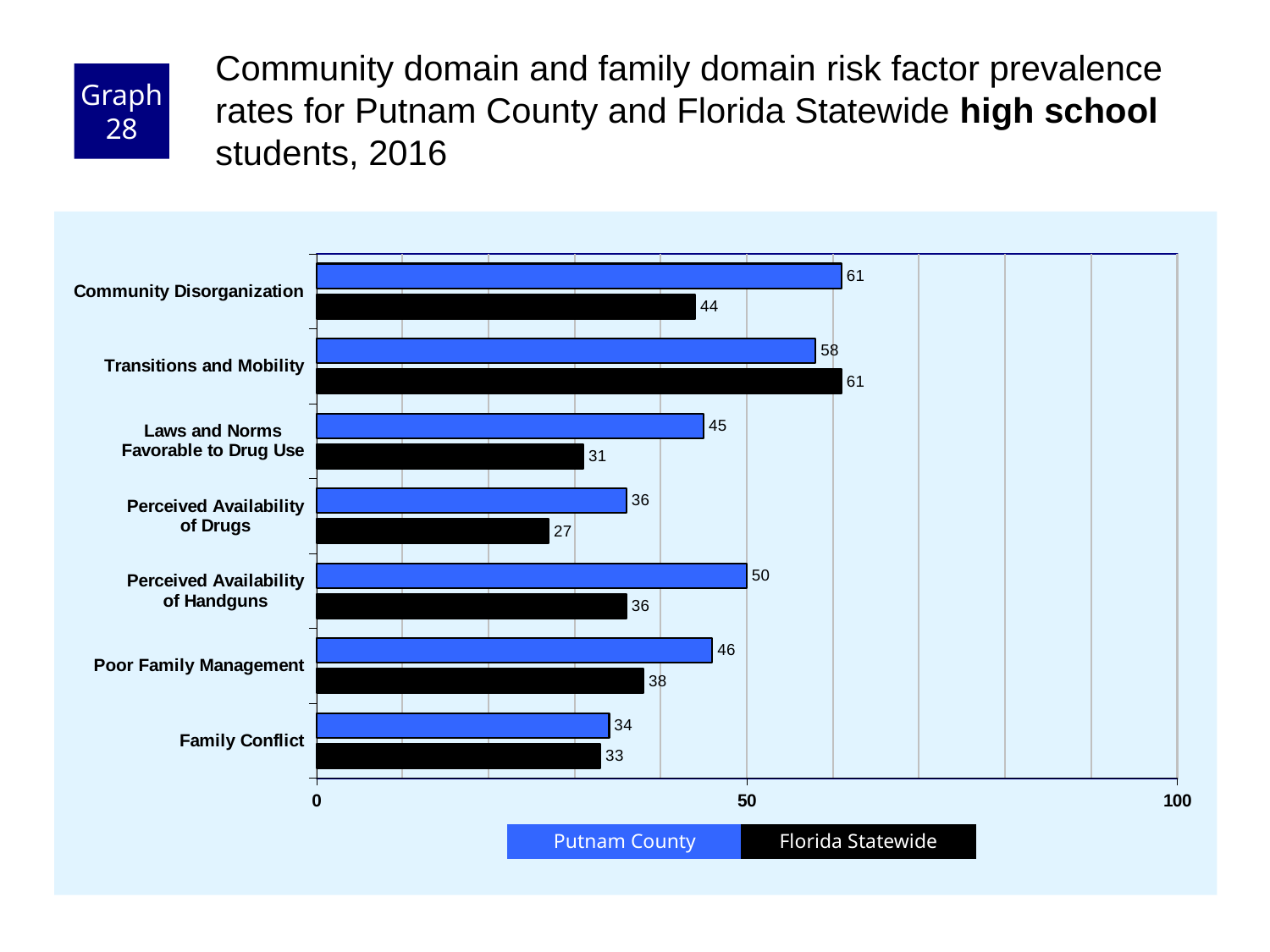
Which is larger for Transitions and Mobility: the Putnam County value or the Florida Statewide value? Florida Statewide What is the Putnam County value for Community Disorganization? 61 Which colour represents Florida Statewide in the chart? Black What is the Florida Statewide value for Perceived Availability of Drugs? 27 What is the Putnam County value for Poor Family Management? 46 What is the difference between the Putnam County and Florida Statewide values for Community Disorganization? 17 Which risk factor has the lowest Florida Statewide value? Perceived Availability of Drugs How many series does the legend list? 2 What kind of chart is shown on the slide? Bar chart How many risk factor categories are shown on the chart? 7 Which risk factor has the highest Putnam County value? Community Disorganization